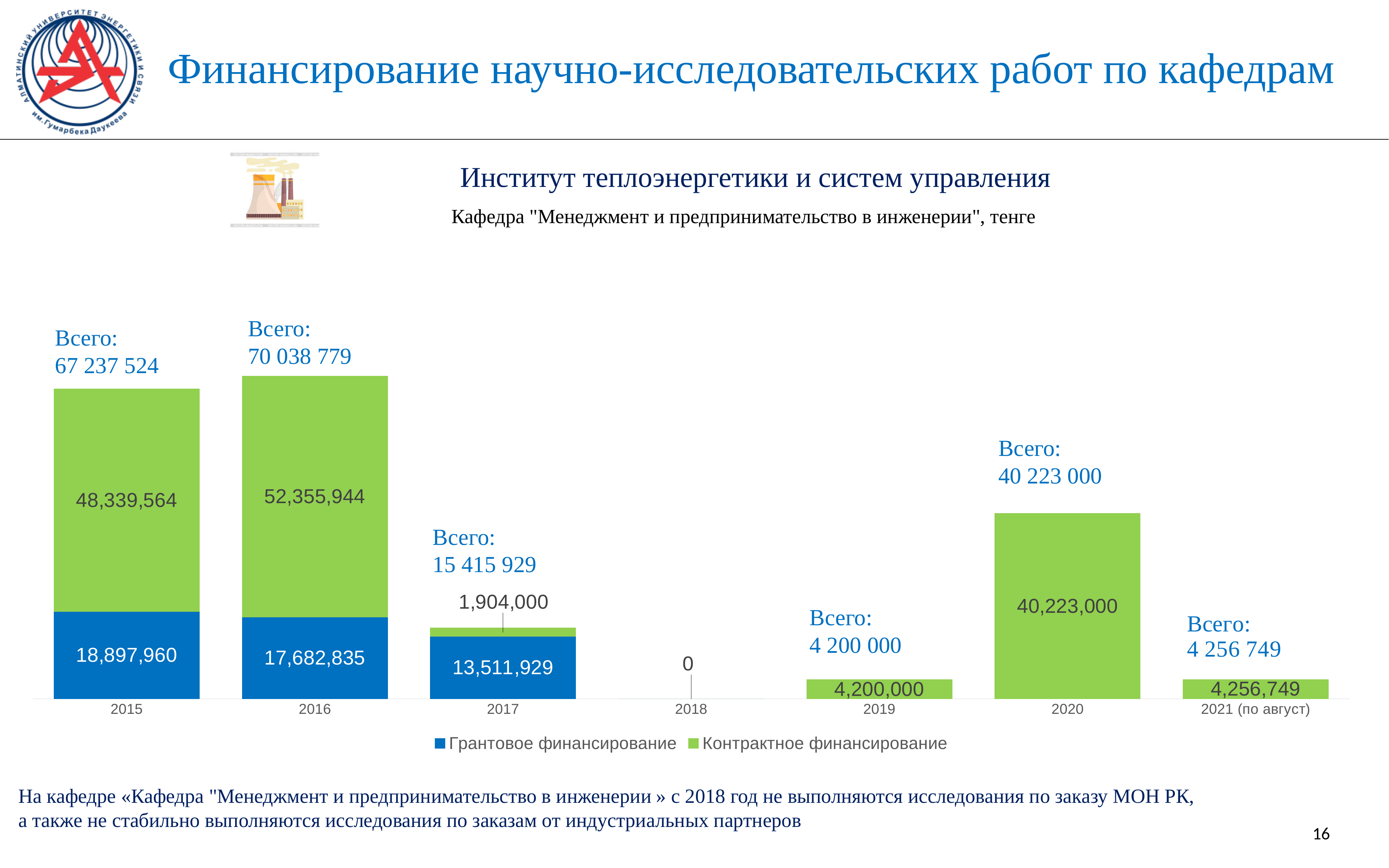
What is the value of Контрактное финансирование for 2017? 1,904,000 How many year categories are shown on the x axis? 7 Which year has the highest total funding? 2016 How many series does the legend list? 2 Which is larger: Грантовое финансирование in 2015 or in 2016? 2015 Which year has the lowest total funding? 2018 What type of chart is shown on the slide? Stacked bar chart What is the value of Грантовое финансирование for 2015? 18,897,960 What is the total (Всего) for 2021 (по август)? 4 256 749 What is the total (Всего) for 2020? 40 223 000 What is the value of Контрактное финансирование for 2016? 52,355,944 What is the difference between Контрактное финансирование in 2016 and in 2015? 4,016,380